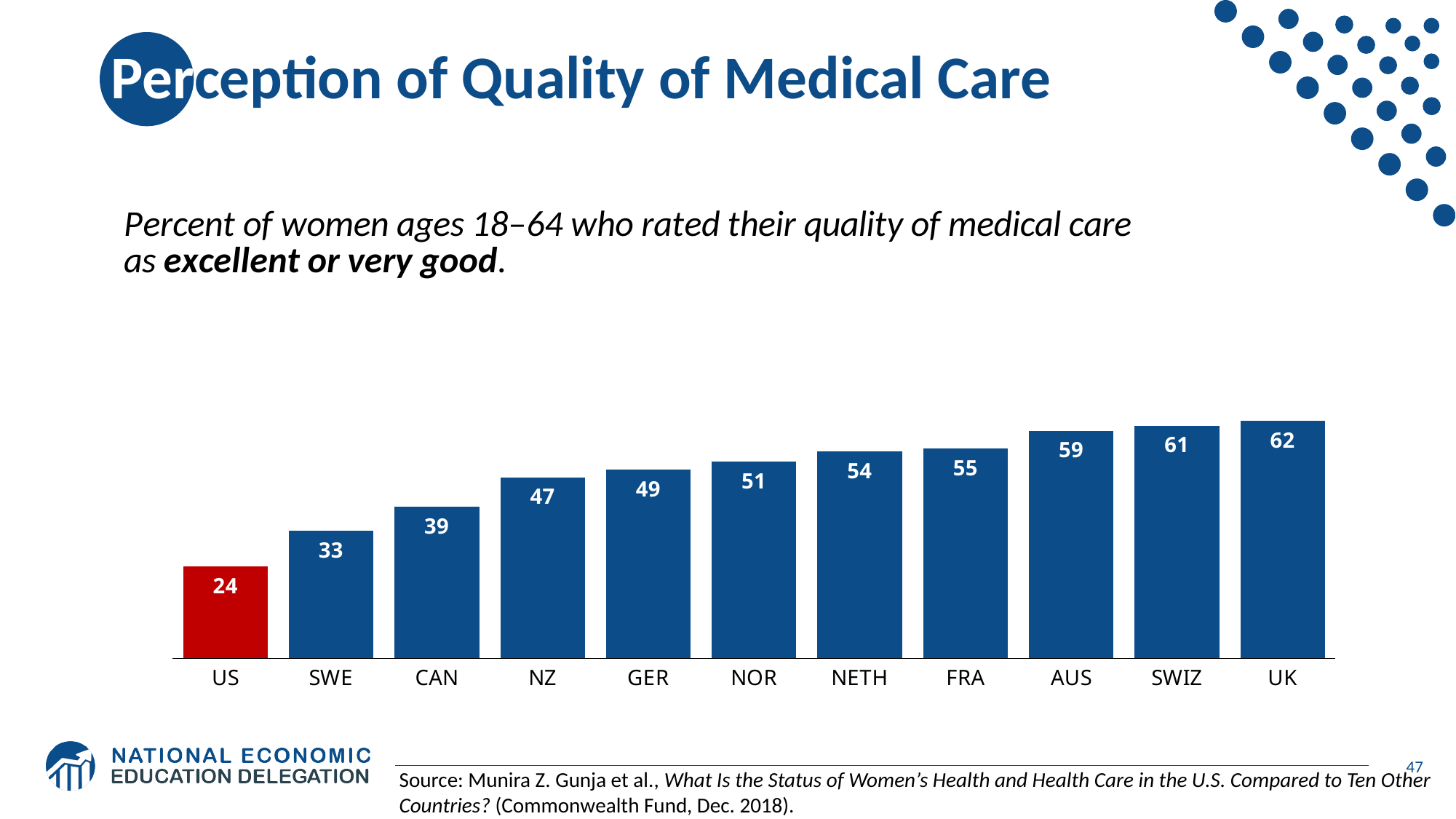
What is the value for AUS? 59 How many countries are shown in the chart? 11 What kind of chart is shown on the slide? bar chart Do the values rise or fall from left to right across the chart? rise Which is larger, the value for NOR or the value for NZ? NOR Which country has the lowest value? US What is the value for the US? 24 Which country has the highest value? UK What is the value for GER? 49 Which bar is coloured red rather than blue? US What is the difference between the values for CAN and SWE? 6 What is the difference between the values for UK and US? 38